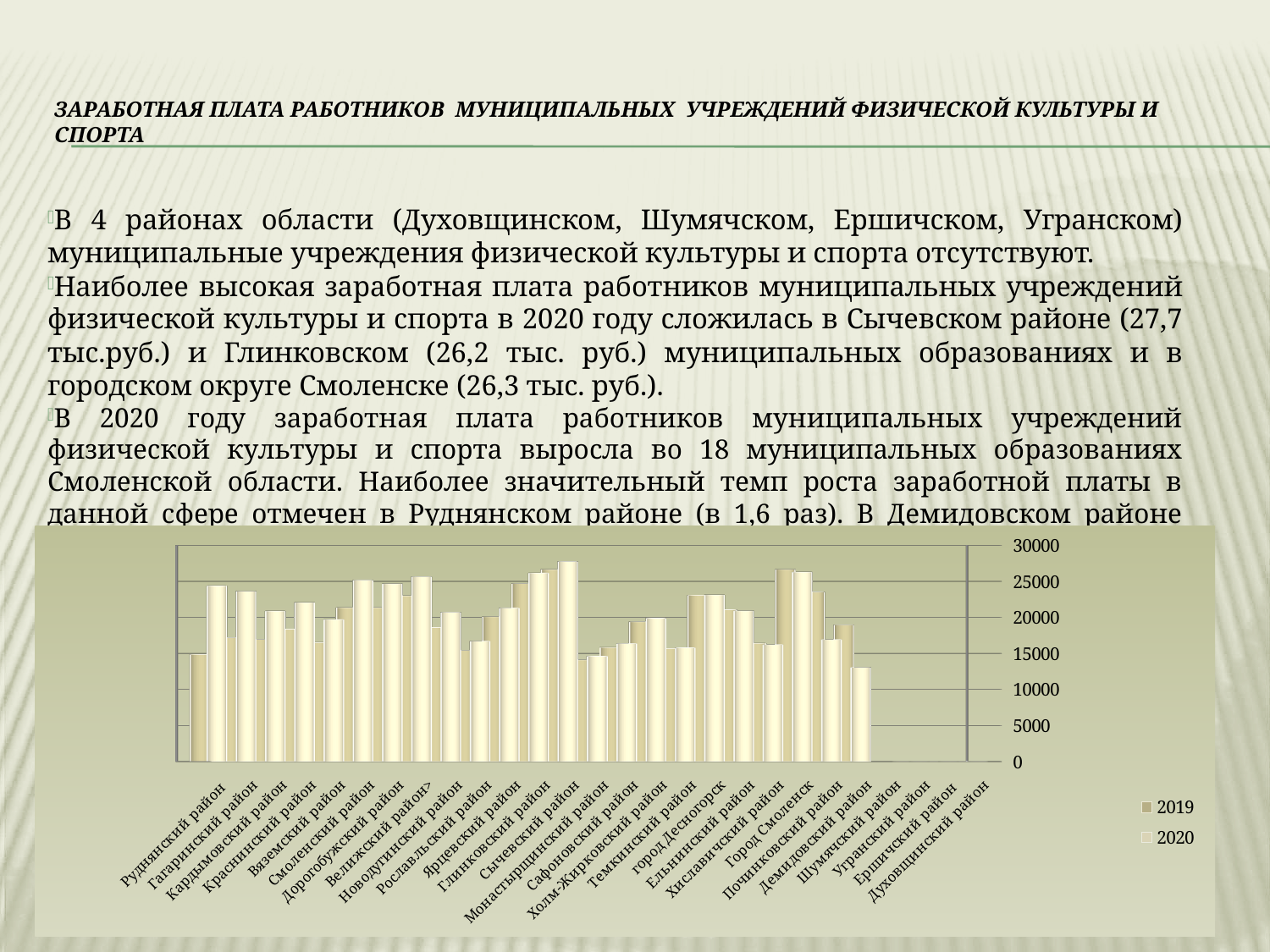
How many categories on the x axis have no bars plotted at all? 4 Is the 2019 value for Руднянский район greater or less than 20000? less Among the categories with plotted bars, which has the lowest 2020 value? Демидовский район Which category has the highest 2020 value in the chart? Сычевский район For Руднянский район, which is larger: the 2019 value or the 2020 value? 2020 How many series does the chart legend list? 2 How many district categories are listed along the x axis of the chart? 27 For Демидовский район, which is larger: the 2019 value or the 2020 value? 2019 What are the two series named in the chart legend? 2019 and 2020 Is the 2020 value for Сычевский район greater or less than 25000? greater Is the 2020 value for Демидовский район greater or less than 15000? less What kind of chart is shown on the slide? bar chart